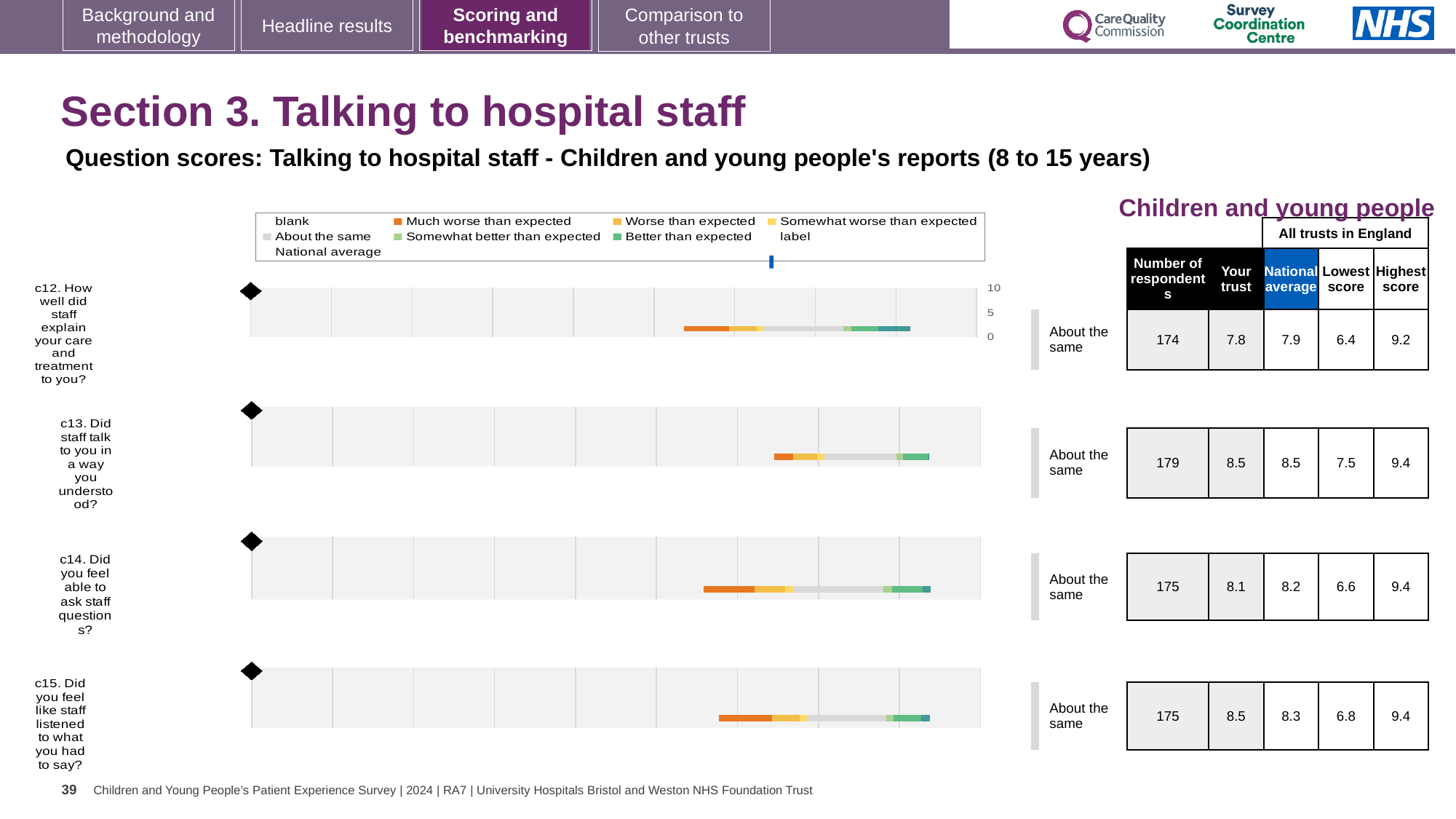
In the chart for c13, what is the highest score among all trusts in England? 9.4 How many question charts are shown on the slide? 4 What kind of chart is used for each question on the slide? Bar chart In the chart for c12 (How well did staff explain your care and treatment to you?), what is the national average score? 7.9 In the chart for c14 (Did you feel able to ask staff questions?), how many respondents are there? 175 For c12, what is the difference between the highest score and the lowest score among all trusts in England? 2.8 In the chart for c15 (Did you feel like staff listened to what you had to say?), what is the lowest score among all trusts in England? 6.8 In the chart for c13 (Did staff talk to you in a way you understood?), what is the 'Your trust' score? 8.5 For c15, which is larger: the 'Your trust' score or the national average? Your trust Which question has the lowest 'Your trust' score on the slide? c12. How well did staff explain your care and treatment to you? What benchmark category is shown next to the chart for c14? About the same Which question has the highest national average score on the slide? c13. Did staff talk to you in a way you understood?